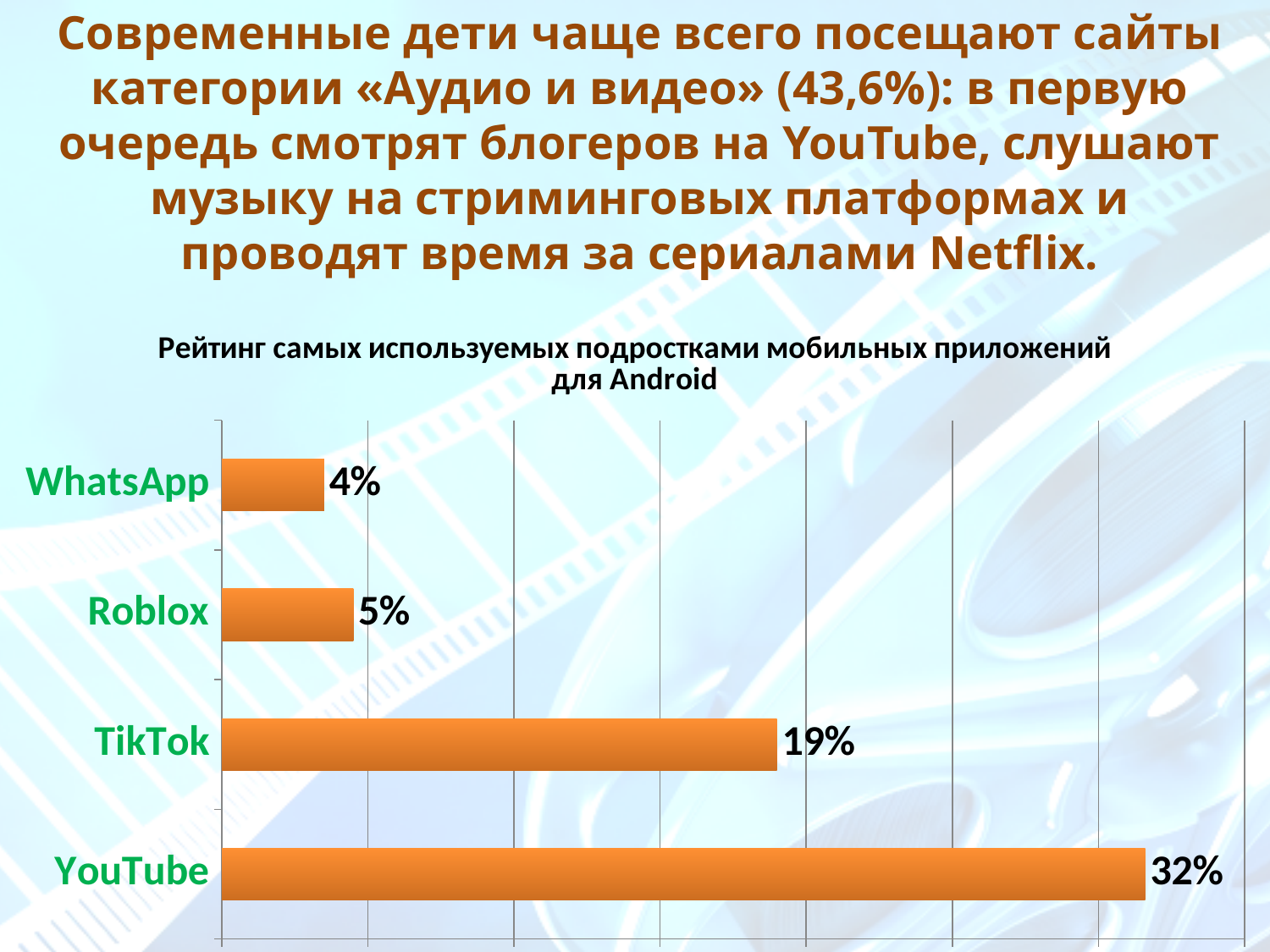
What is the value for Roblox? 5% Which is larger, the value for TikTok or the value for Roblox? TikTok What is the value for YouTube? 32% What is the difference between the values for YouTube and TikTok? 13% What is the difference between the values for Roblox and WhatsApp? 1% Which app has the lowest value? WhatsApp How many apps are shown in the chart? 4 What is the value for TikTok? 19% What is the value for WhatsApp? 4% Which app has the highest value? YouTube What is the title of the chart? Рейтинг самых используемых подростками мобильных приложений для Android What kind of chart is shown on the slide? Bar chart